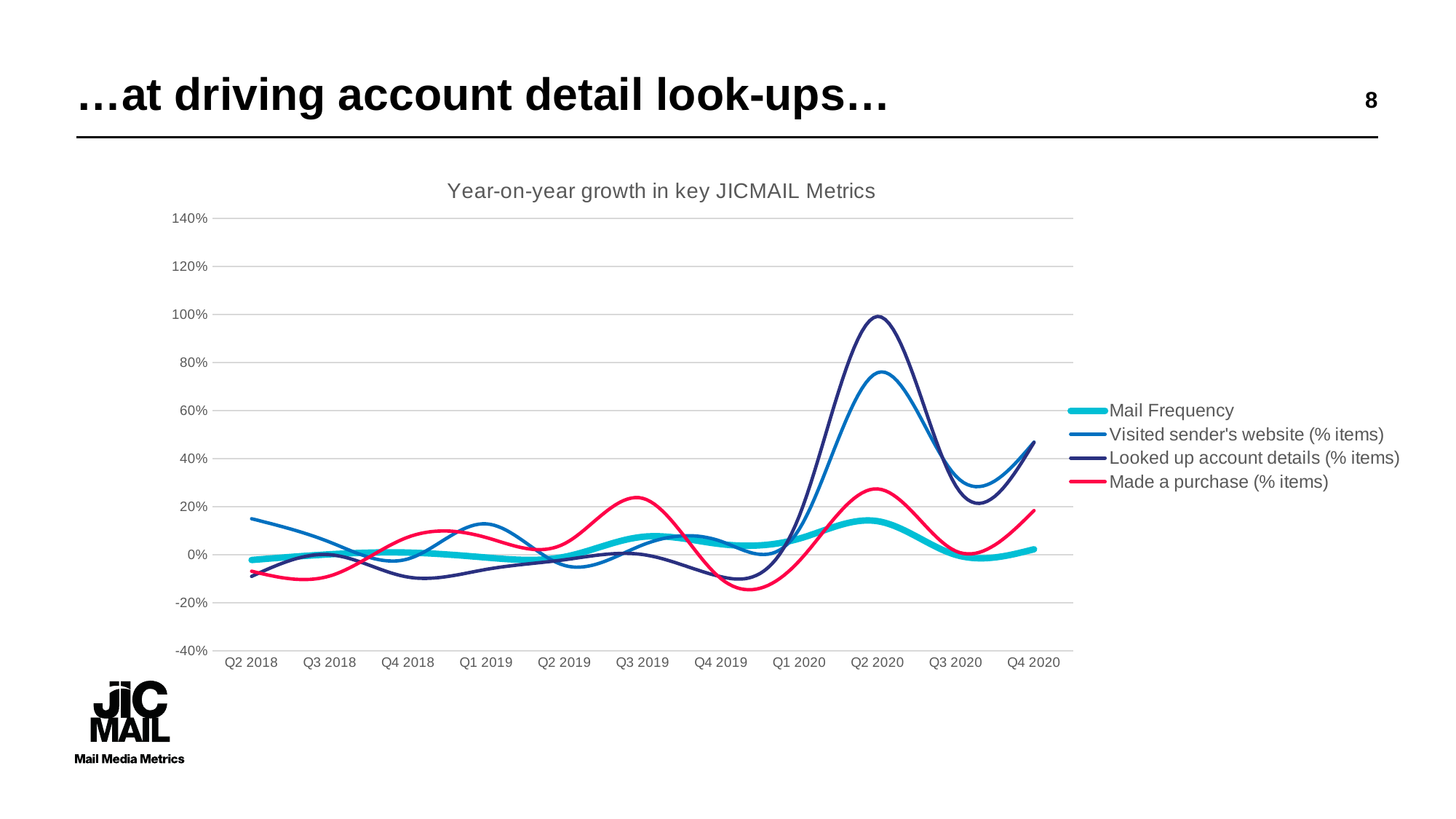
How many quarters are shown along the x axis? 11 Is the value for Visited sender's website (% items) in Q2 2020 greater or less than 60%? greater What kind of chart is shown on the slide? line chart Does the Looked up account details (% items) line rise or fall from Q2 2020 to Q3 2020? fall Is the value for Looked up account details (% items) in Q2 2020 greater or less than 80%? greater What is the title of the chart? Year-on-year growth in key JICMAIL Metrics Which series reaches the highest value in Q2 2020? Looked up account details (% items) What colour is the Made a purchase (% items) line? red In which quarter does Looked up account details (% items) reach its highest value? Q2 2020 In Q2 2020, is Made a purchase (% items) higher or lower than Mail Frequency? higher How many series does the legend list? 4 Is the value for Mail Frequency in Q2 2020 greater or less than 20%? less